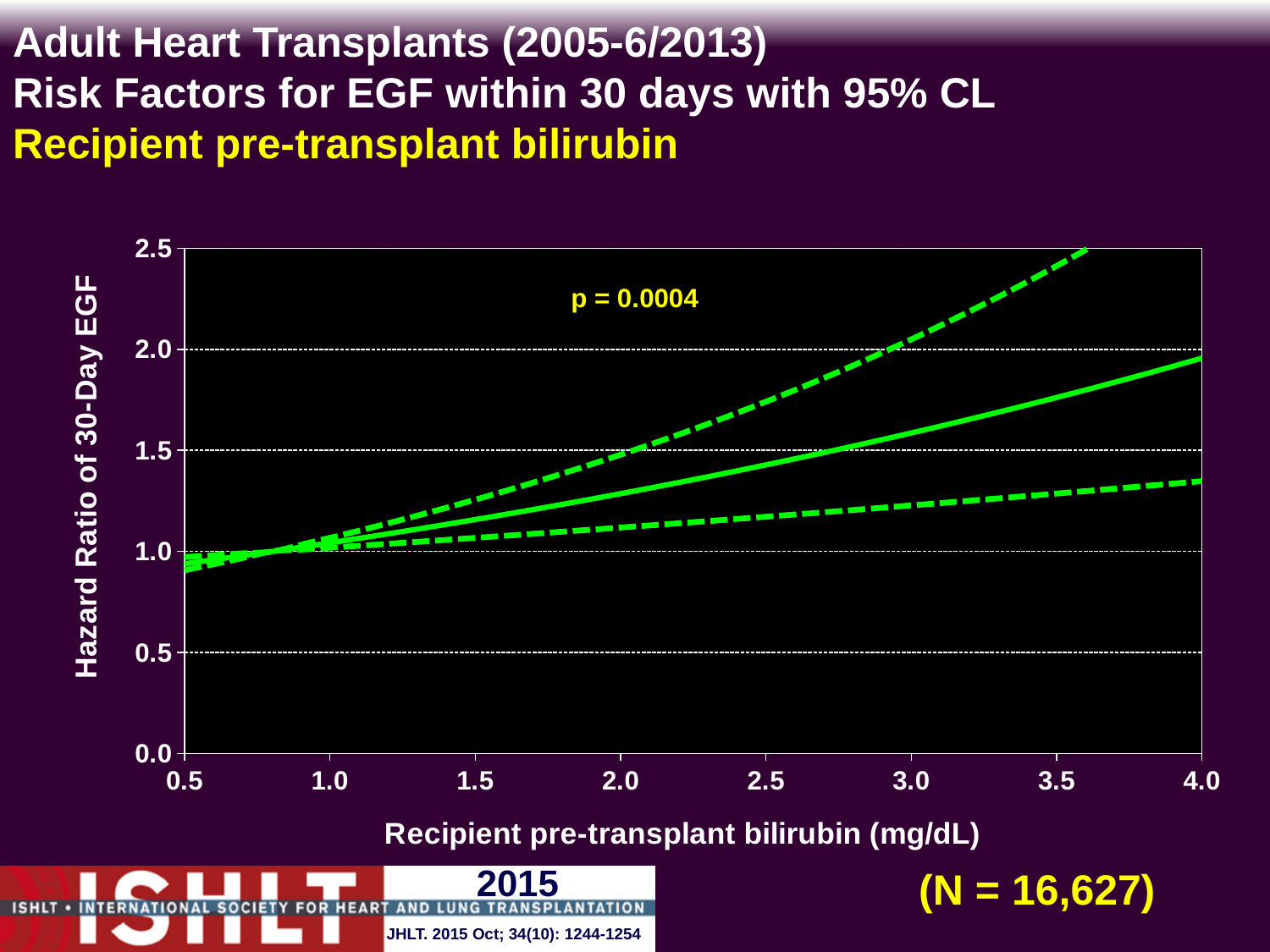
Is the hazard ratio (solid line) at a bilirubin of 2.0 mg/dL greater or less than 1.5? less How many lines are plotted on the chart? 3 Is the upper 95% confidence limit (upper dashed line) at a bilirubin of 2.5 mg/dL greater or less than 1.5? greater What p-value is shown on the chart? p = 0.0004 Is the hazard ratio (solid line) at a bilirubin of 2.0 mg/dL greater or less than 1.0? greater Does the hazard ratio of 30-day EGF (solid line) rise or fall as recipient pre-transplant bilirubin increases? rise What kind of chart is shown on the slide? line chart What is the label of the x axis of the chart? Recipient pre-transplant bilirubin (mg/dL)